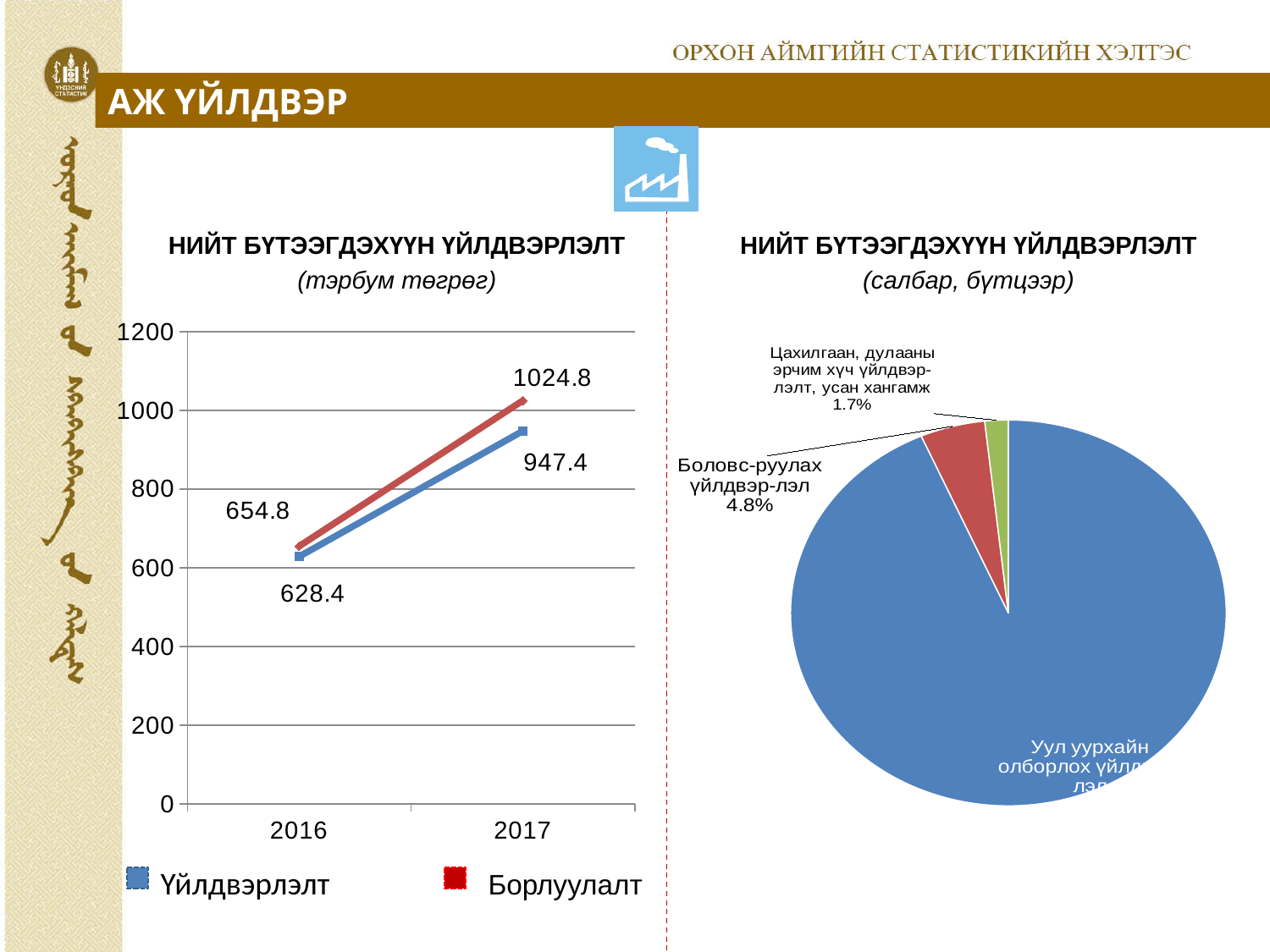
In the left chart (тэрбум төгрөг), what is the value of Борлуулалт in 2016? 654.8 In the left chart (тэрбум төгрөг), by how much did Үйлдвэрлэлт increase from 2016 to 2017? 319.0 In the left chart (тэрбум төгрөг), what is the value of Үйлдвэрлэлт in 2017? 947.4 In the left chart (тэрбум төгрөг), which series has the higher value in 2016, Үйлдвэрлэлт or Борлуулалт? Борлуулалт How many series does the legend of the left chart (тэрбум төгрөг) list? 2 In the right pie chart (салбар, бүтцээр), what share does Боловсруулах үйлдвэрлэл have? 4.8% In the right pie chart (салбар, бүтцээр), which slice is the largest? Уул уурхайн олборлох үйлдвэрлэл In the left chart (тэрбум төгрөг), what is the value of Үйлдвэрлэлт in 2016? 628.4 What kind of chart is the left chart (тэрбум төгрөг)? line chart In the left chart (тэрбум төгрөг), what is the difference between Борлуулалт and Үйлдвэрлэлт in 2017? 77.4 In the left chart (тэрбум төгрөг), what is the value of Борлуулалт in 2017? 1024.8 In the left chart (тэрбум төгрөг), do the values rise or fall from 2016 to 2017? rise